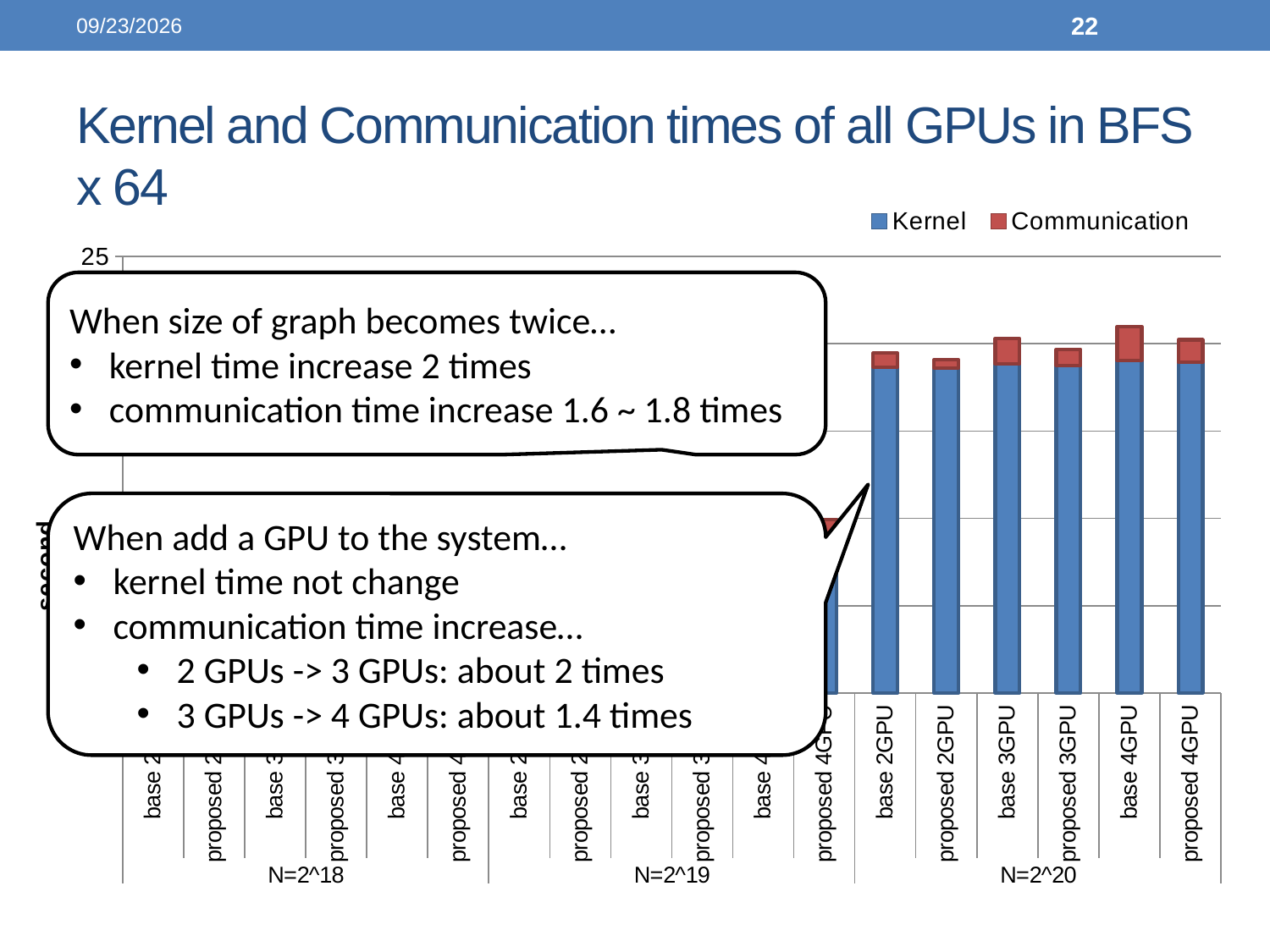
Within the N=2^20 group, which configuration has the tallest stacked bar? base 4GPU How many graph-size groups (N values) are shown on the x axis? 3 Which series is drawn in red? Communication What kind of chart is shown on the slide? stacked bar chart What is the highest value labelled on the y axis? 25 How many series does the legend list? 2 In the N=2^20 group, is the total for base 4GPU greater or less than 25? less What are the two series named in the legend? Kernel and Communication In the N=2^20 group, which has the larger total: base 2GPU or proposed 2GPU? base 2GPU How many bars are in the N=2^20 group? 6 In the N=2^20 group, which has the larger total: base 4GPU or proposed 4GPU? base 4GPU